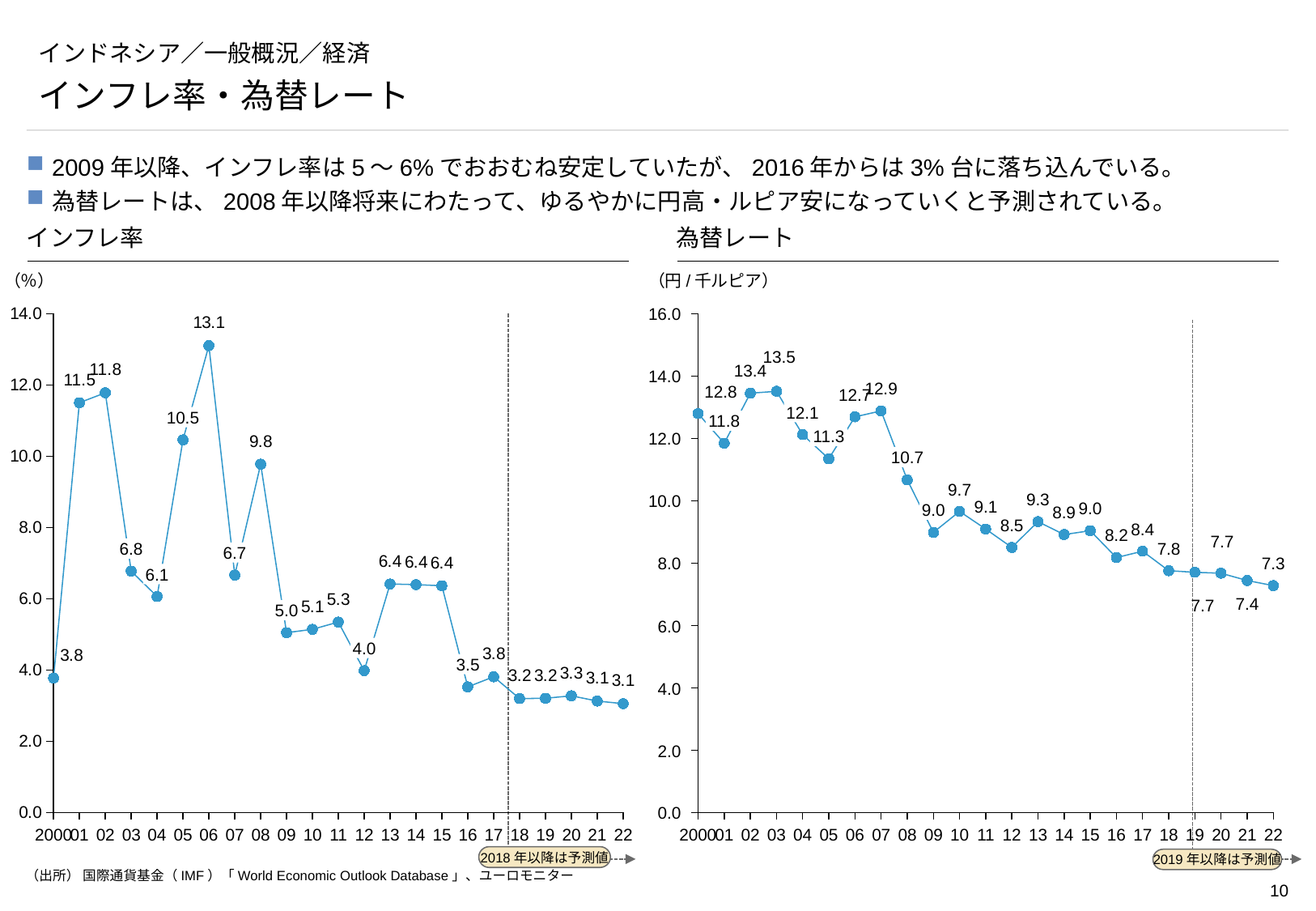
On the インフレ率 chart, what is the difference between the values for 2001 and 2000? 7.7 On the インフレ率 chart, which year has the highest value? 2006 What unit is shown on the y axis of the 為替レート chart? 円/千ルピア What kind of chart is the インフレ率 chart? line chart On the 為替レート chart, do the values generally rise or fall from 2007 to 2022? fall On the インフレ率 chart, what is the value for 2006? 13.1 On the インフレ率 chart, how many data points are plotted? 23 On the 為替レート chart, which year has the lowest value? 2022 On the 為替レート chart, what is the value for 2008? 10.7 On the インフレ率 chart, which is larger, the value for 2008 or the value for 2005? 2005 On the 為替レート chart, what is the difference between the values for 2003 and 2022? 6.2 On the 為替レート chart, which year has the highest value? 2003